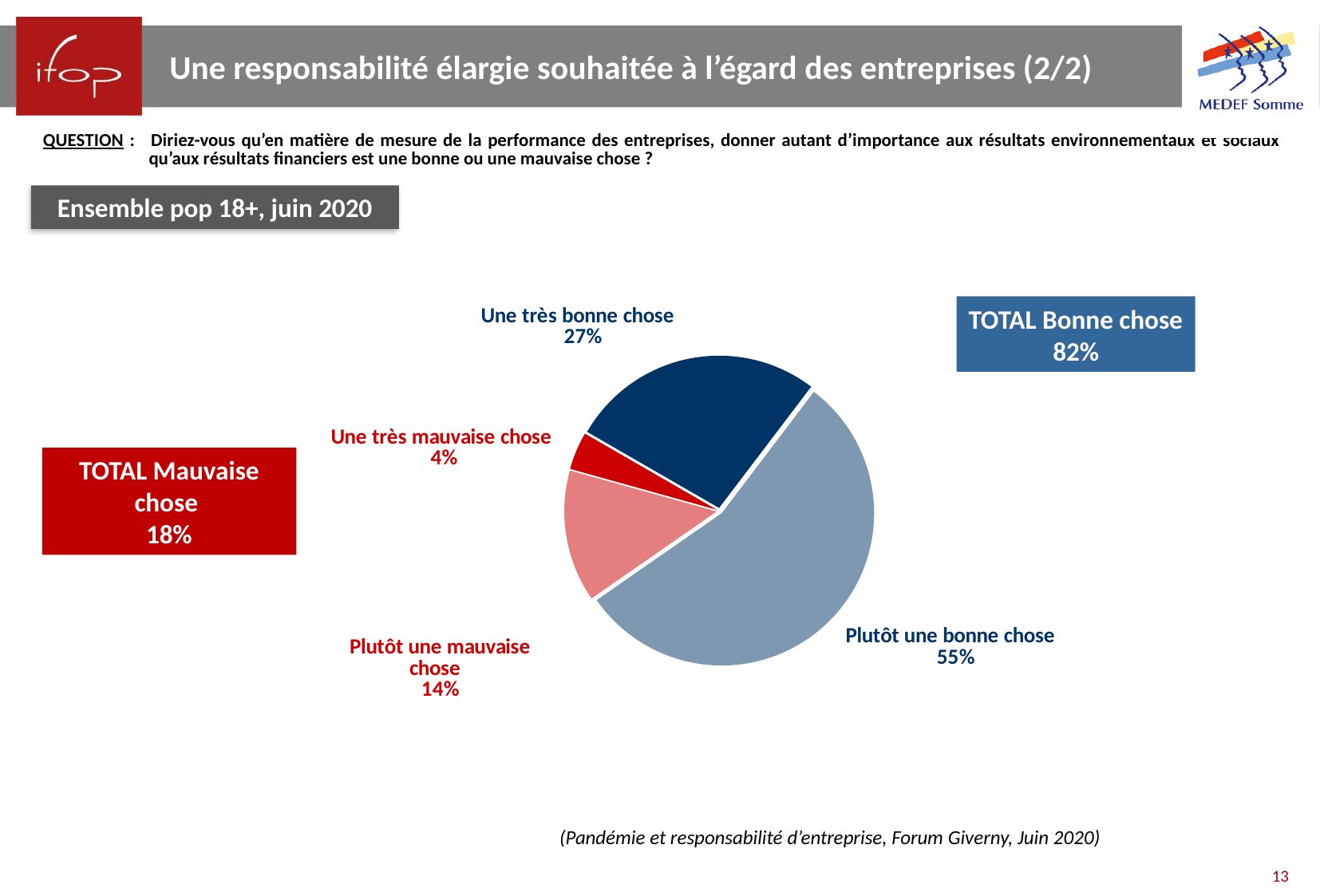
What share of respondents answered "Plutôt une mauvaise chose"? 14% Which response has the largest slice of the pie? Plutôt une bonne chose What share of respondents answered "Une très bonne chose"? 27% What kind of chart is shown on the slide? Pie chart What share of respondents answered "Plutôt une bonne chose"? 55% What is the value shown in the "TOTAL Mauvaise chose" box? 18% What share of respondents answered "Une très mauvaise chose"? 4% What is the value shown in the "TOTAL Bonne chose" box? 82% Which response has the smallest slice of the pie? Une très mauvaise chose Which is larger: "Plutôt une mauvaise chose" or "Une très mauvaise chose"? Plutôt une mauvaise chose How many slices does the pie chart have? 4 What is the difference in percentage points between "Plutôt une bonne chose" and "Une très bonne chose"? 28 percentage points